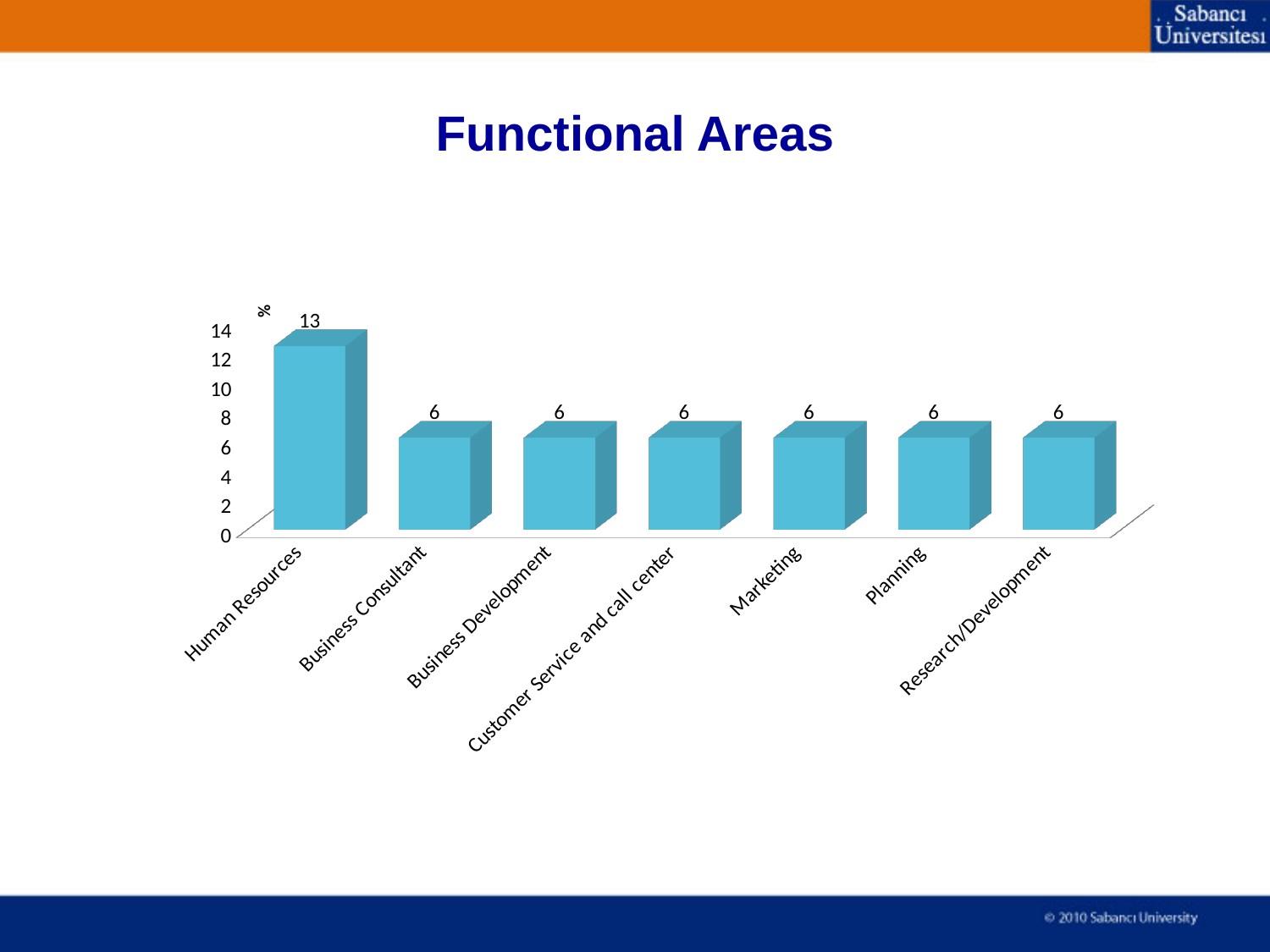
What is the difference between the values for Human Resources and Planning? 7 Is the value for Business Development greater or less than 10? less Which is larger, the value for Human Resources or the value for Business Consultant? Human Resources What is the value for Human Resources? 13 What kind of chart is shown on the slide? bar chart What is the value for Customer Service and call center? 6 What is the value for Marketing? 6 Is the value for Human Resources greater or less than 10? greater What is the value for Research/Development? 6 Which functional area has the highest value? Human Resources How many functional areas are shown on the chart? 7 What is the title of the chart? Functional Areas